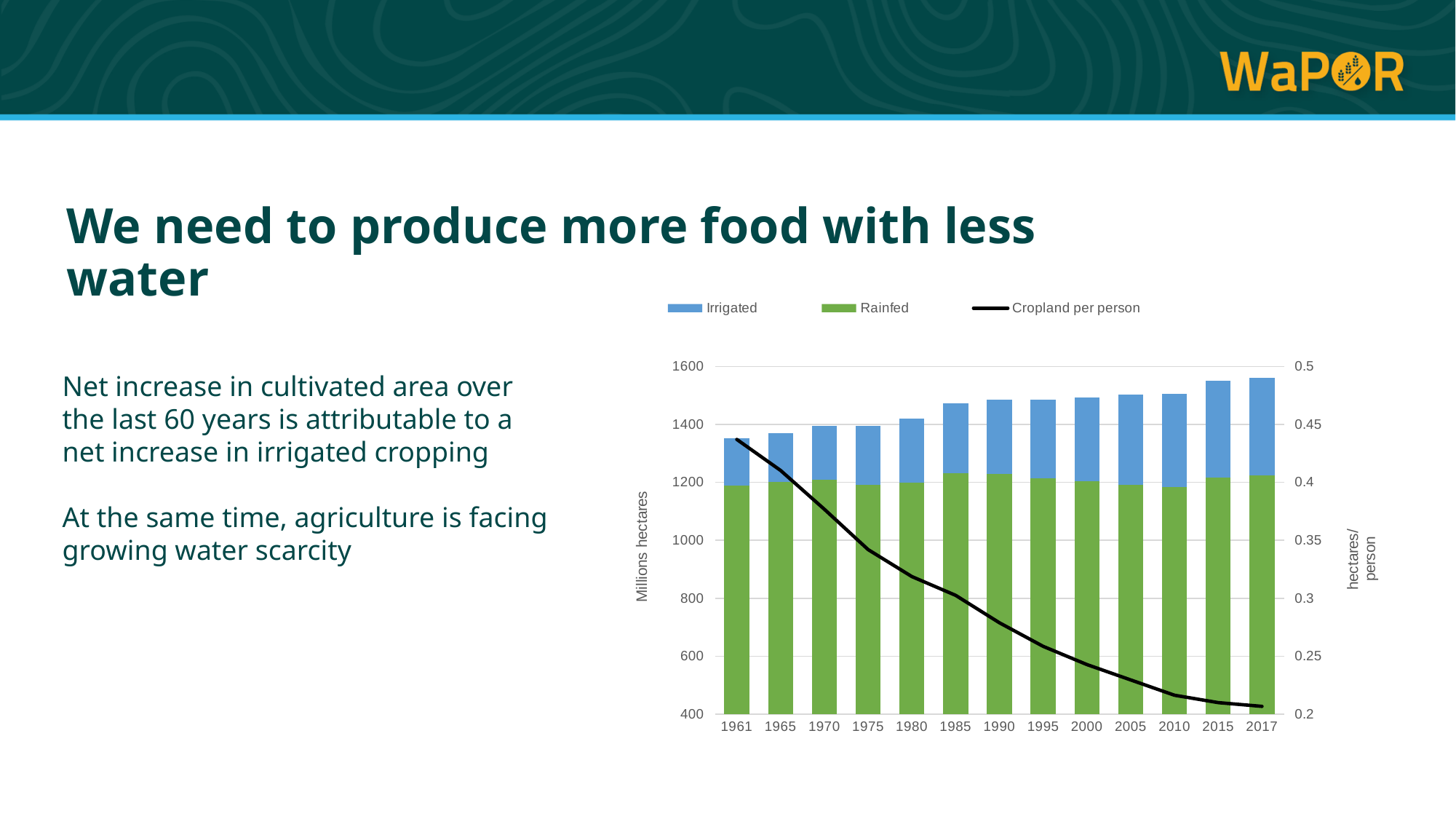
Which year has the highest total cultivated area (tallest stacked bar)? 2017 What kind of chart is shown on the slide? A stacked bar chart with a line Which year has the lowest total cultivated area (shortest stacked bar)? 1961 What is the label on the left vertical axis of the chart? Millions hectares How many series does the chart legend list? 3 Does the Cropland per person line rise or fall from 1961 to 2017? Fall Is the Cropland per person value for 1961 greater or less than 0.4 hectares/person? greater Is the Cropland per person value for 2017 greater or less than 0.25 hectares/person? less Is the total cultivated area for 1961 greater or less than 1400 million hectares? less Which is larger, the total cultivated area in 2017 or in 1961? 2017 How many years are shown along the x axis of the chart? 13